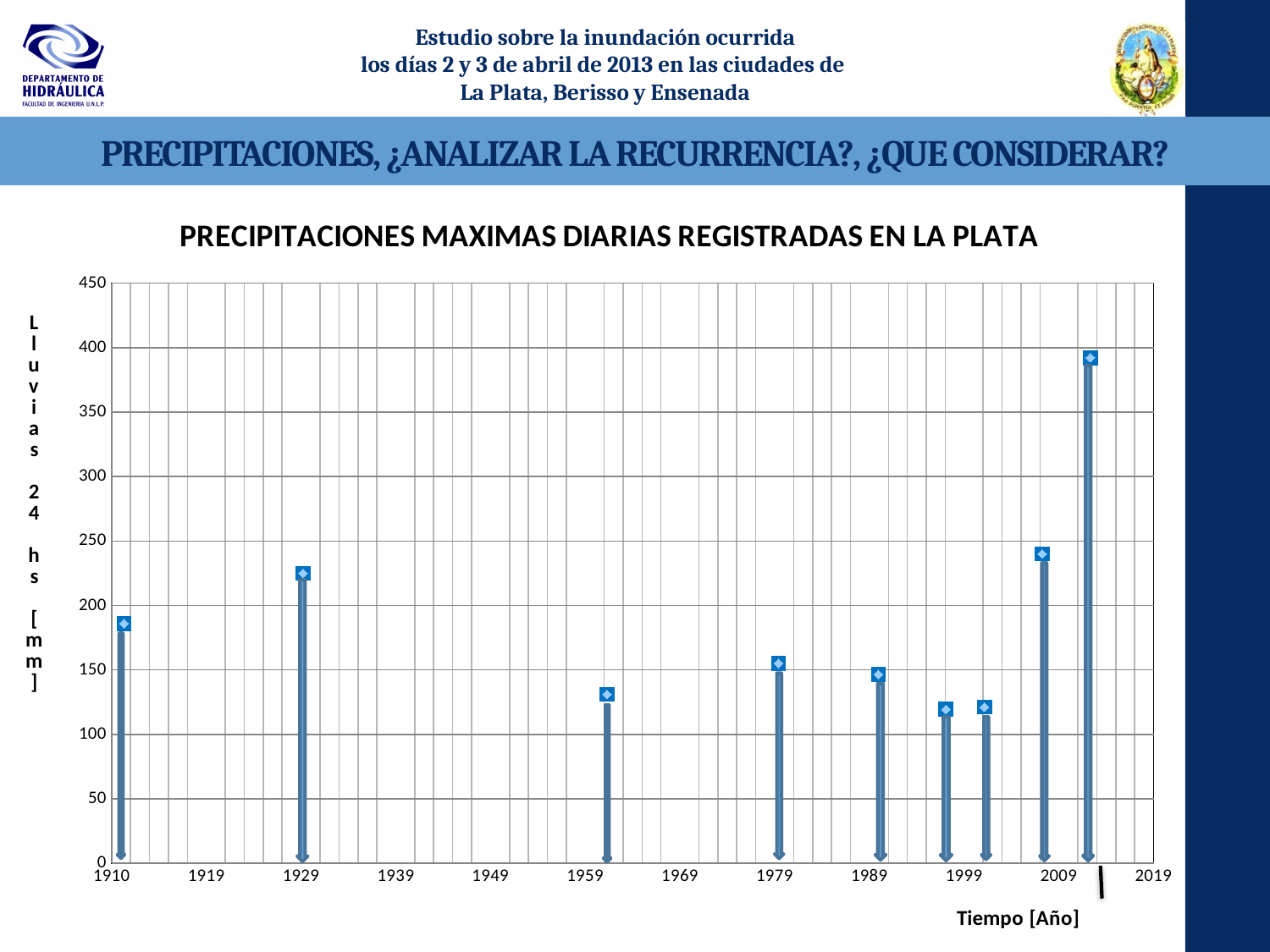
Is the value of the highest point on the chart greater or less than 350? greater What is the maximum value shown on the y axis of the chart? 450 Which plotted point has the highest value on the chart? The point just after 2009 (around 2013) Which is larger: the value of the point just before 2009 or the value of the point just after 1910? The point just before 2009 Is the value of the point plotted just after 1910 greater or less than 200? less Is the value of the point plotted just after 1929 greater or less than 200? greater Which is larger: the value of the point just after 1929 or the value of the point just after 1979? The point just after 1929 What is the label of the x axis of the chart? Tiempo [Año] How many data points are plotted on the chart? 9 What is the title of the chart? PRECIPITACIONES MAXIMAS DIARIAS REGISTRADAS EN LA PLATA